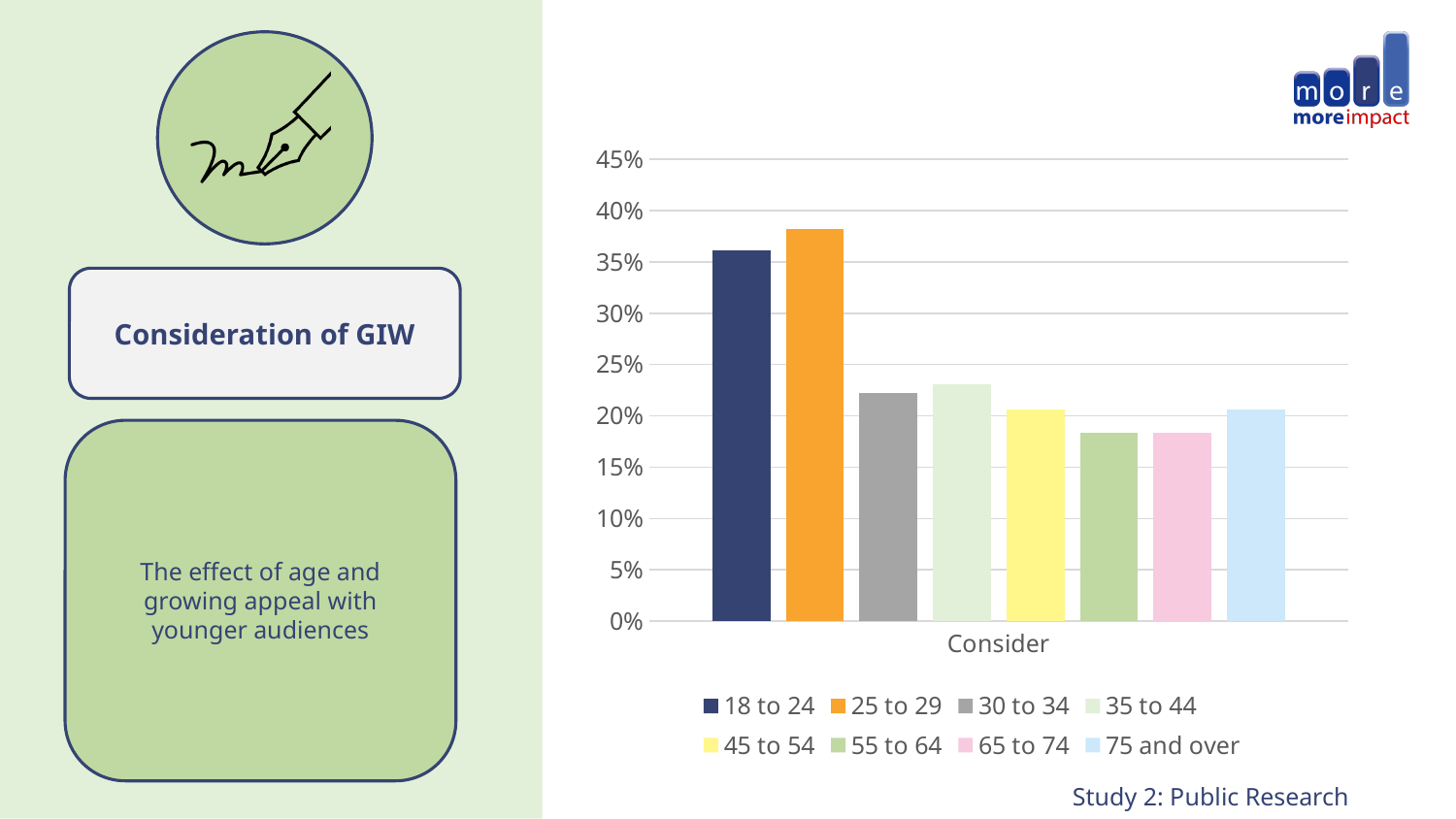
What kind of chart is shown on the slide? bar chart Is the value for 55 to 64 greater or less than 20%? less Which age group has the highest value for Consider? 25 to 29 Which is larger, the value for 18 to 24 or the value for 65 to 74? 18 to 24 Which is larger, the value for 25 to 29 or the value for 30 to 34? 25 to 29 Is the value for 18 to 24 greater or less than 30%? greater What is the category label shown on the x axis? Consider How many categories are shown on the x axis? 1 Is the value for 30 to 34 greater or less than 20%? greater How many series does the legend list? 8